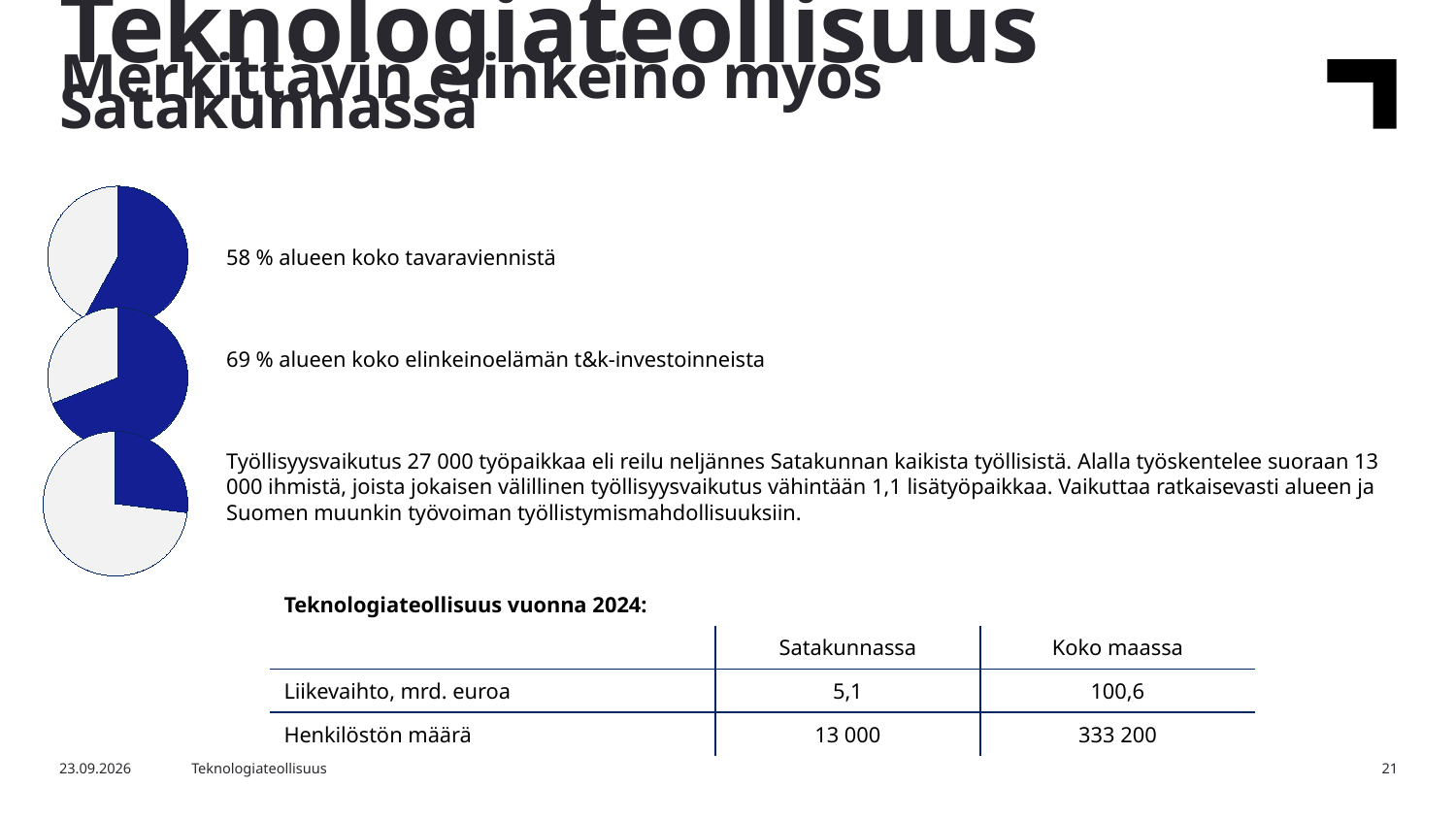
What kind of charts are shown on the left side of the slide? pie charts How many pie charts are on the slide? 3 According to the label next to the top pie chart, what share of the region's total goods exports (tavaravienti) does the technology industry account for? 58 % According to the label next to the middle pie chart, what share of the region's business R&D investments (t&k-investoinnit) does the technology industry account for? 69 % Which of the three pie charts has the largest blue slice? the middle one (t&k-investoinnit) Which of the three pie charts has the smallest blue slice? the bottom one (työllisyysvaikutus) By how many percentage points does the technology industry's share of R&D investments (69 %) exceed its share of goods exports (58 %)? 11 percentage points Is the blue slice of the bottom pie chart (työllisyysvaikutus) greater or less than 50%? less What does the top pie chart represent, according to the text next to it? 58 % alueen koko tavaraviennistä What colour is used for the highlighted slice in each pie chart? blue Is the blue slice of the middle pie chart (t&k-investoinnit) greater or less than 50%? greater Which pie chart has the larger blue slice, the top one (tavaravienti) or the middle one (t&k-investoinnit)? the middle one (t&k-investoinnit)